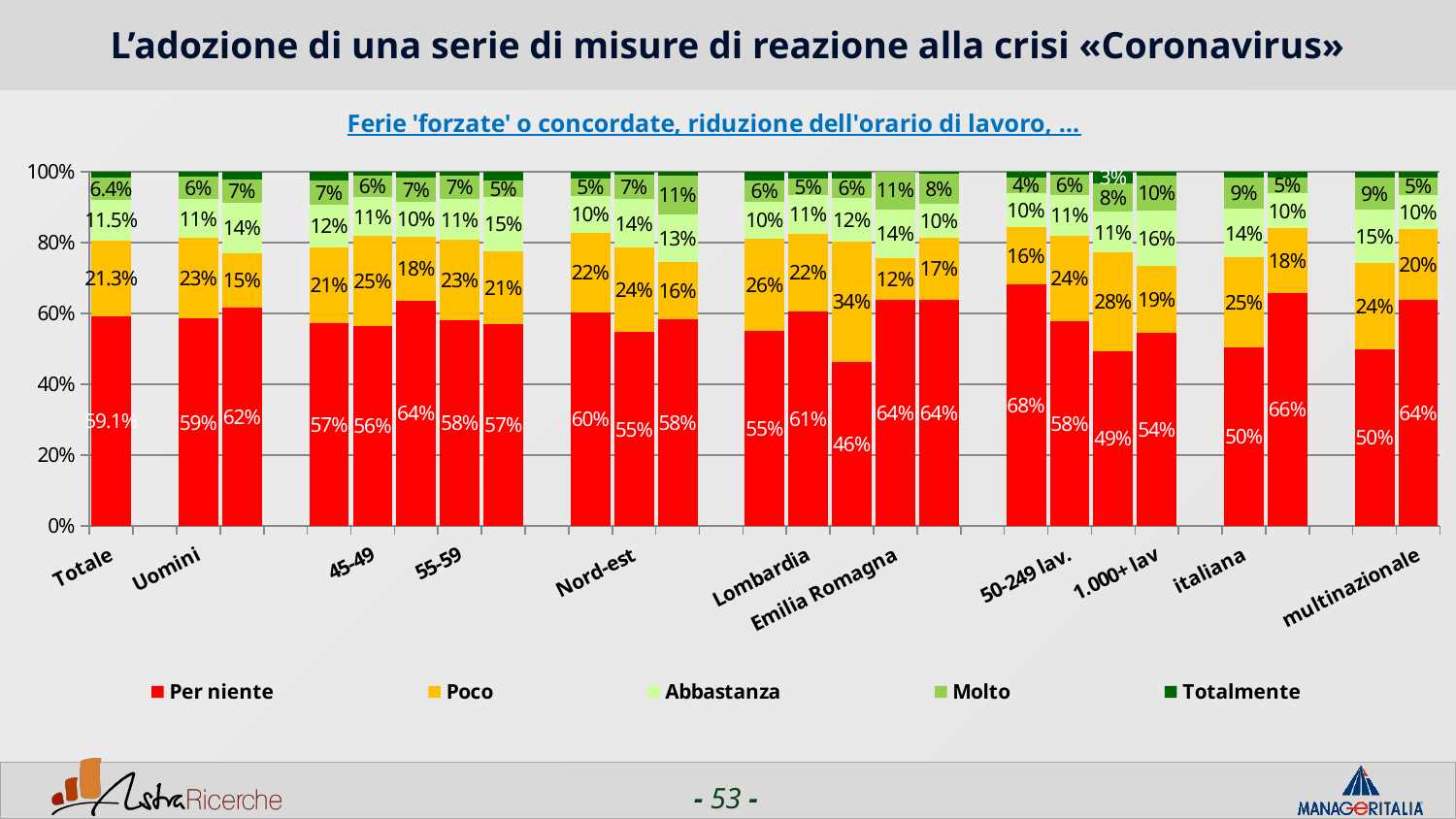
What is the 'Per niente' value for multinazionale? 64% What kind of chart is shown on the slide? Stacked bar chart How many series does the legend list? 5 What is the 'Poco' value for italiana? 25% What is the 'Per niente' value for Totale? 59.1% What is the 'Per niente' value for Uomini? 59% Which has the larger 'Per niente' value, italiana or multinazionale? multinazionale What is the 'Molto' value for Totale? 6.4% What is the 'Poco' value for Totale? 21.3% What is the difference between the 'Per niente' values for multinazionale and italiana? 14 percentage points Which series is listed first in the legend? Per niente Is the 'Per niente' value for Totale greater or less than 40%? greater